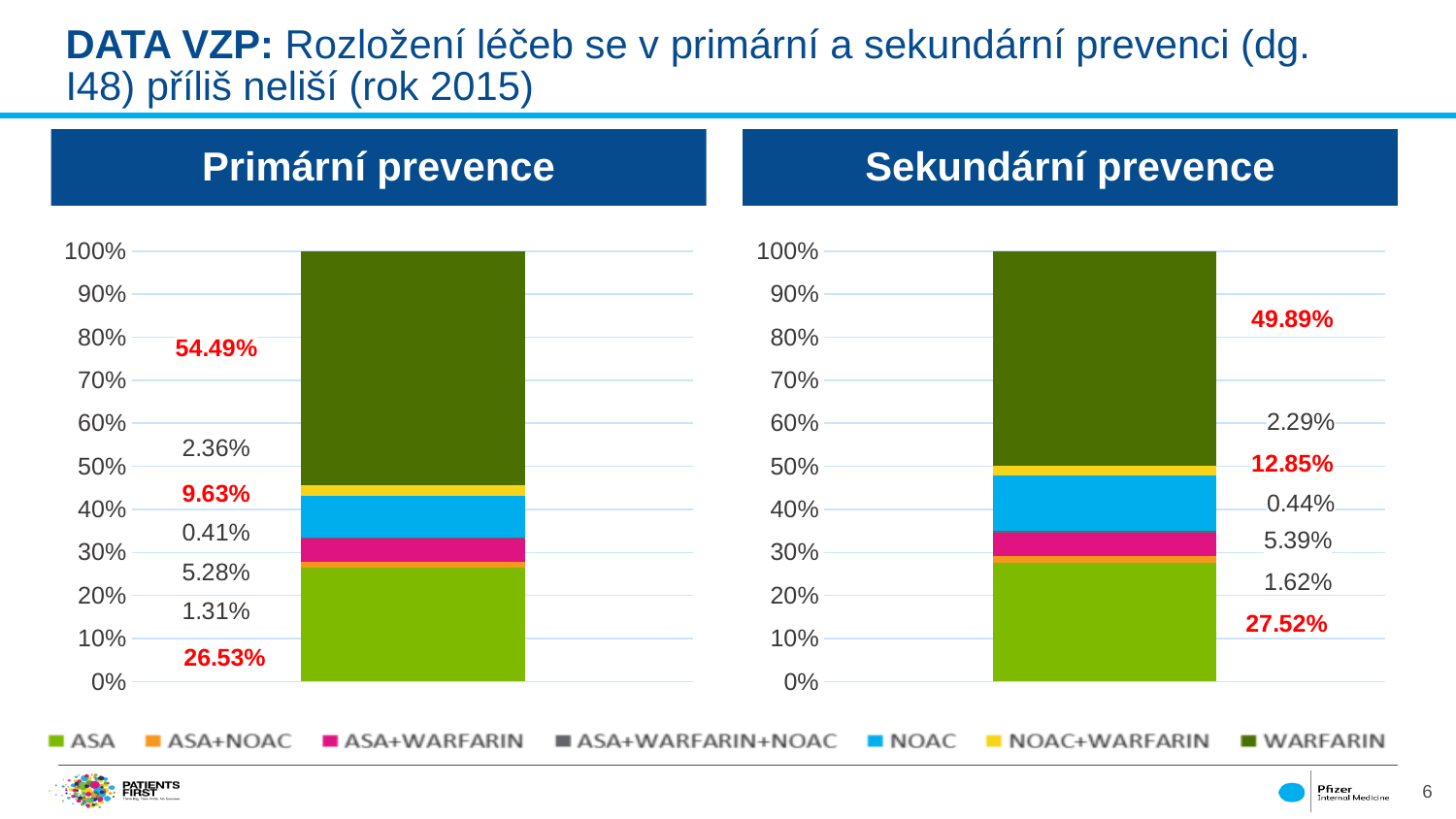
How many series does the legend list? 7 In the Sekundární prevence chart, what is the value for WARFARIN? 49.89% What type of chart is used on the slide for Primární prevence and Sekundární prevence? Stacked bar chart In the Primární prevence chart, what is the value for ASA? 26.53% In the Primární prevence chart, what is the value for NOAC? 9.63% In the Primární prevence chart, what is the value for WARFARIN? 54.49% In the Sekundární prevence chart, what is the value for NOAC? 12.85% In the Sekundární prevence chart, which series has the smallest share? ASA+WARFARIN+NOAC What is the difference between the WARFARIN value in the Primární prevence chart and the WARFARIN value in the Sekundární prevence chart? 4.60% Which is larger: the NOAC value in the Primární prevence chart or the NOAC value in the Sekundární prevence chart? Sekundární prevence In the Primární prevence chart, which series has the largest share? WARFARIN In the Sekundární prevence chart, what is the value for ASA? 27.52%